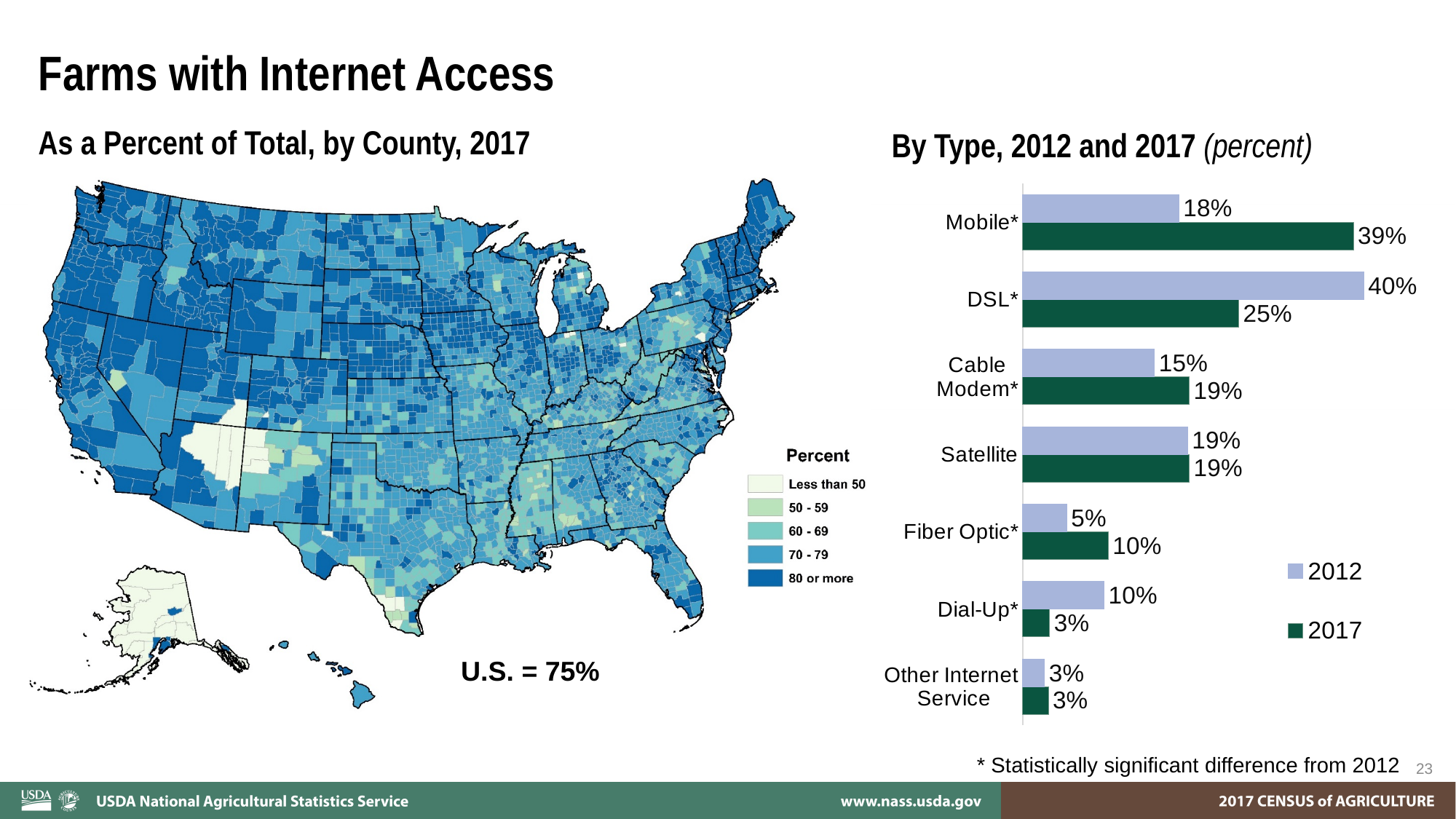
How many internet types are shown in the 'By Type, 2012 and 2017' chart? 7 In the 'By Type, 2012 and 2017' chart, what is the 2017 value for Mobile*? 39% What kind of chart is the 'By Type, 2012 and 2017' chart? Bar chart In the 'By Type, 2012 and 2017' chart, what is the difference between the 2012 and 2017 values for DSL*? 15% How many series does the legend of the 'By Type, 2012 and 2017' chart list? 2 In the 'By Type, 2012 and 2017' chart, which type has the highest 2017 value? Mobile* In the 'By Type, 2012 and 2017' chart, what is the 2017 value for Dial-Up*? 3% In the 'By Type, 2012 and 2017' chart, what is the 2012 value for DSL*? 40% What is the U.S. value shown on the map 'As a Percent of Total, by County, 2017'? 75% In the 'By Type, 2012 and 2017' chart, which type has the lowest 2012 value? Other Internet Service In the 'By Type, 2012 and 2017' chart, what is the difference between the 2017 and 2012 values for Mobile*? 21% In the 'By Type, 2012 and 2017' chart, which is larger for Fiber Optic*: the 2012 value or the 2017 value? 2017